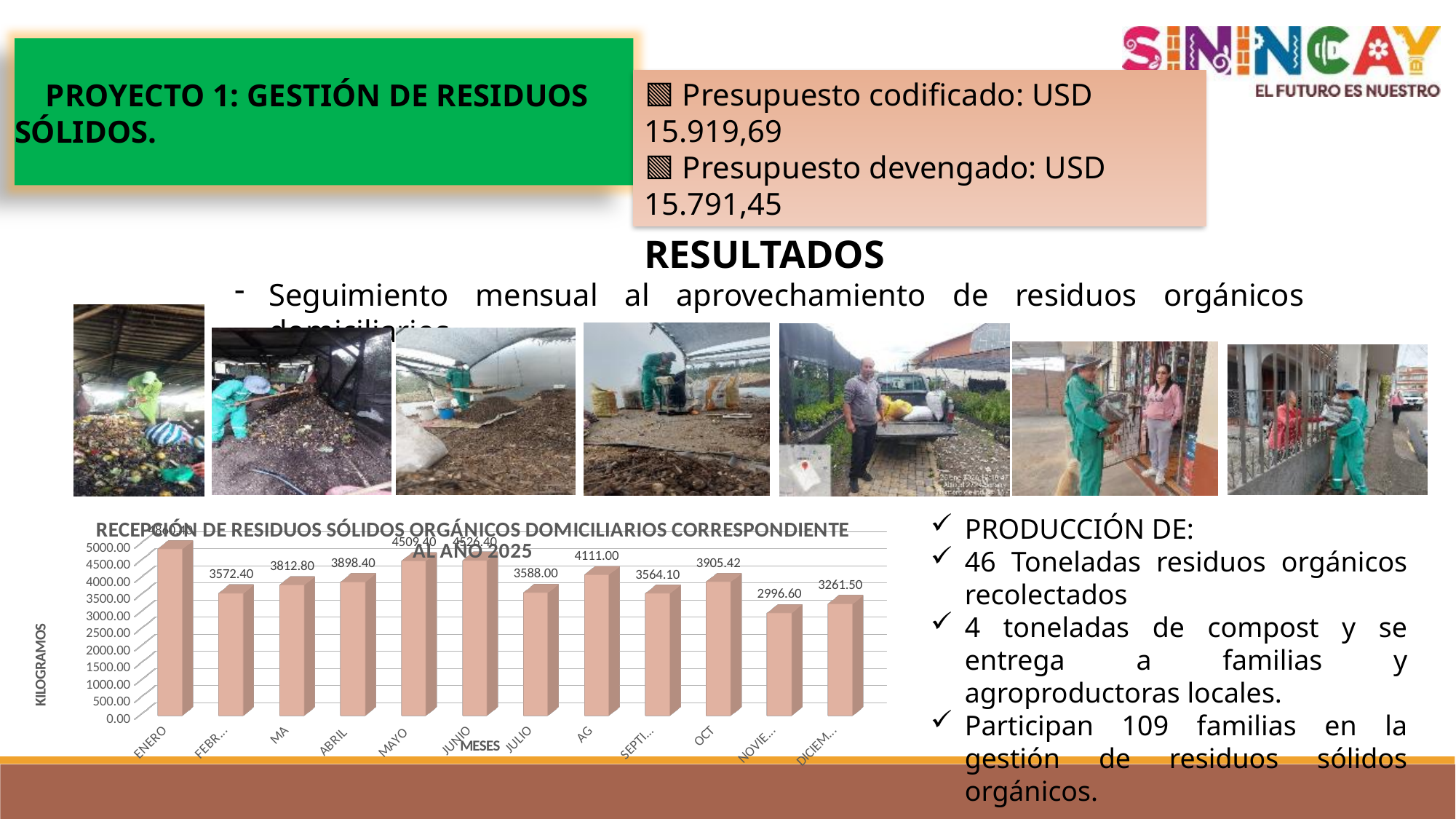
Which month has the lowest value in the chart? NOVIE... (Noviembre) What is the value for OCT in the chart? 3905.42 What is the value for JULIO in the chart? 3588.00 Which is larger, the value for JULIO or the value for ABRIL? ABRIL How many months (categories) are shown in the chart? 12 What kind of chart is shown on the slide? bar chart Is the value for ENERO greater or less than 4500.00? greater What is the value for ABRIL in the chart? 3898.40 Which month has the highest bar in the chart? ENERO What is the label of the vertical axis of the chart? KILOGRAMOS What is the difference between the values for JUNIO and MAYO? 17.00 What is the value for MAYO in the chart? 4509.40